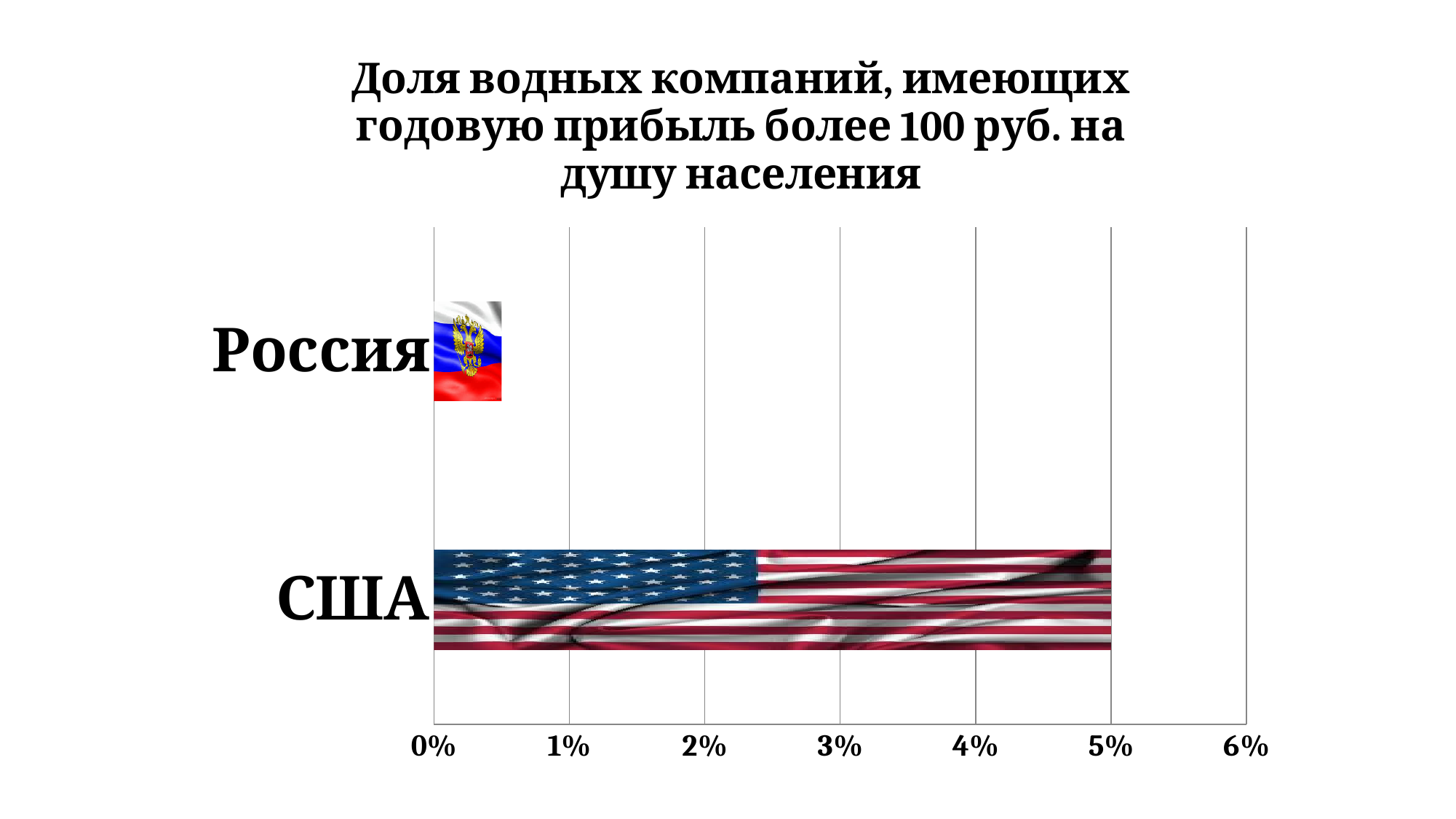
What is the maximum value shown on the horizontal axis? 6% What is the value for США? 5% What is the title of the chart? Доля водных компаний, имеющих годовую прибыль более 100 руб. на душу населения Which category has the lowest value? Россия Which category has the highest value? США What kind of chart is shown on the slide? bar chart Is the value for США greater or less than 4%? greater How many categories are shown in the chart? 2 Is the value for Россия greater or less than 1%? less Which is larger, the value for Россия or the value for США? США